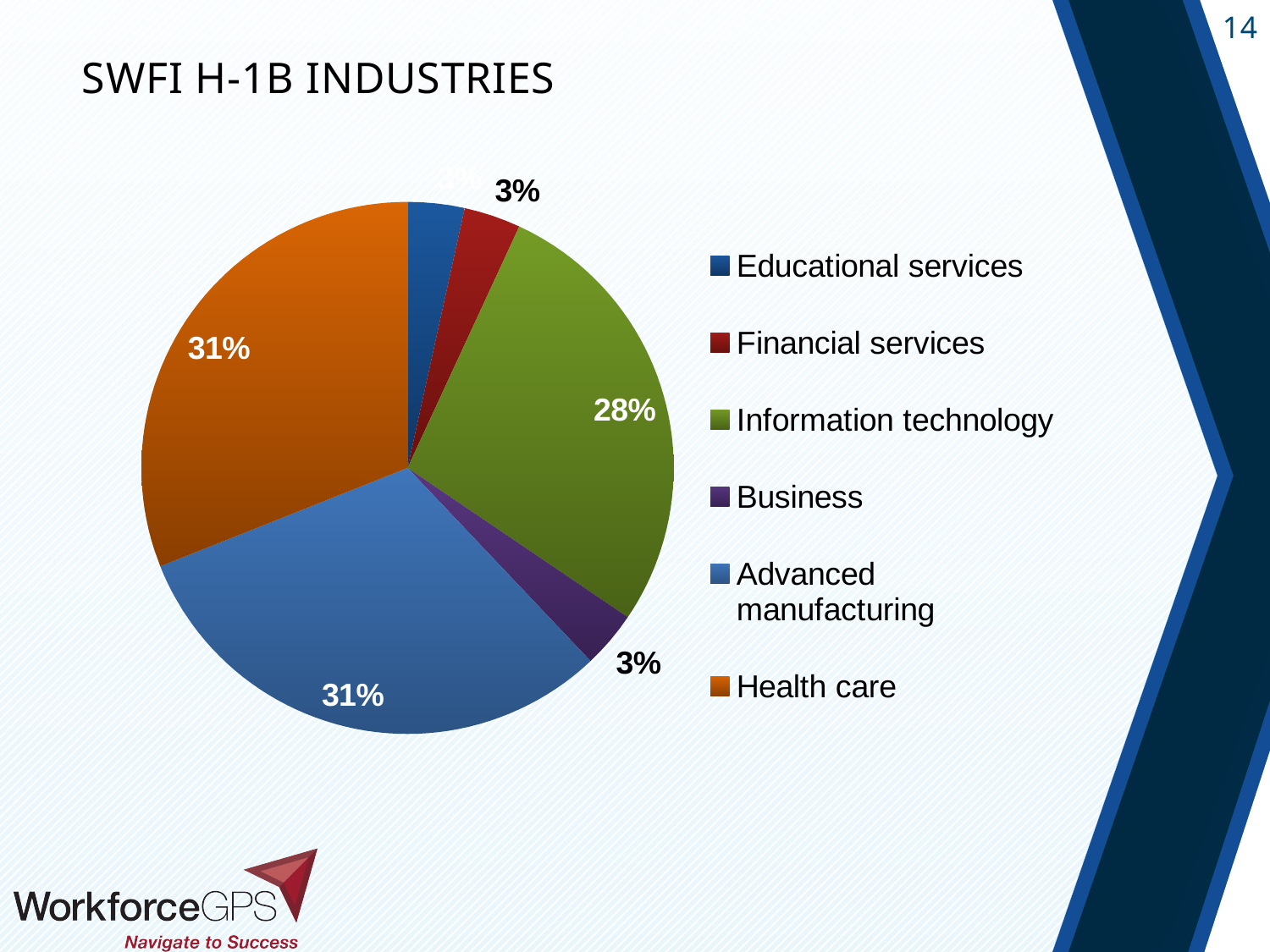
What percentage is shown for Business? 3% What is the difference between the Health care share and the Information technology share? 3 percentage points Which is larger, the Business slice or the Information technology slice? Information technology What colour is the Health care slice in the pie chart? Orange What type of chart is shown on the slide? Pie chart What is the value shown for Advanced manufacturing? 31% What is the value shown for Health care? 31% Which is larger, the Information technology slice or the Health care slice? Health care What percentage of the pie does Information technology represent? 28% What is the title of the slide containing the chart? SWFI H-1B INDUSTRIES How many industry categories are shown in the pie chart? 6 What percentage is shown for Financial services? 3%